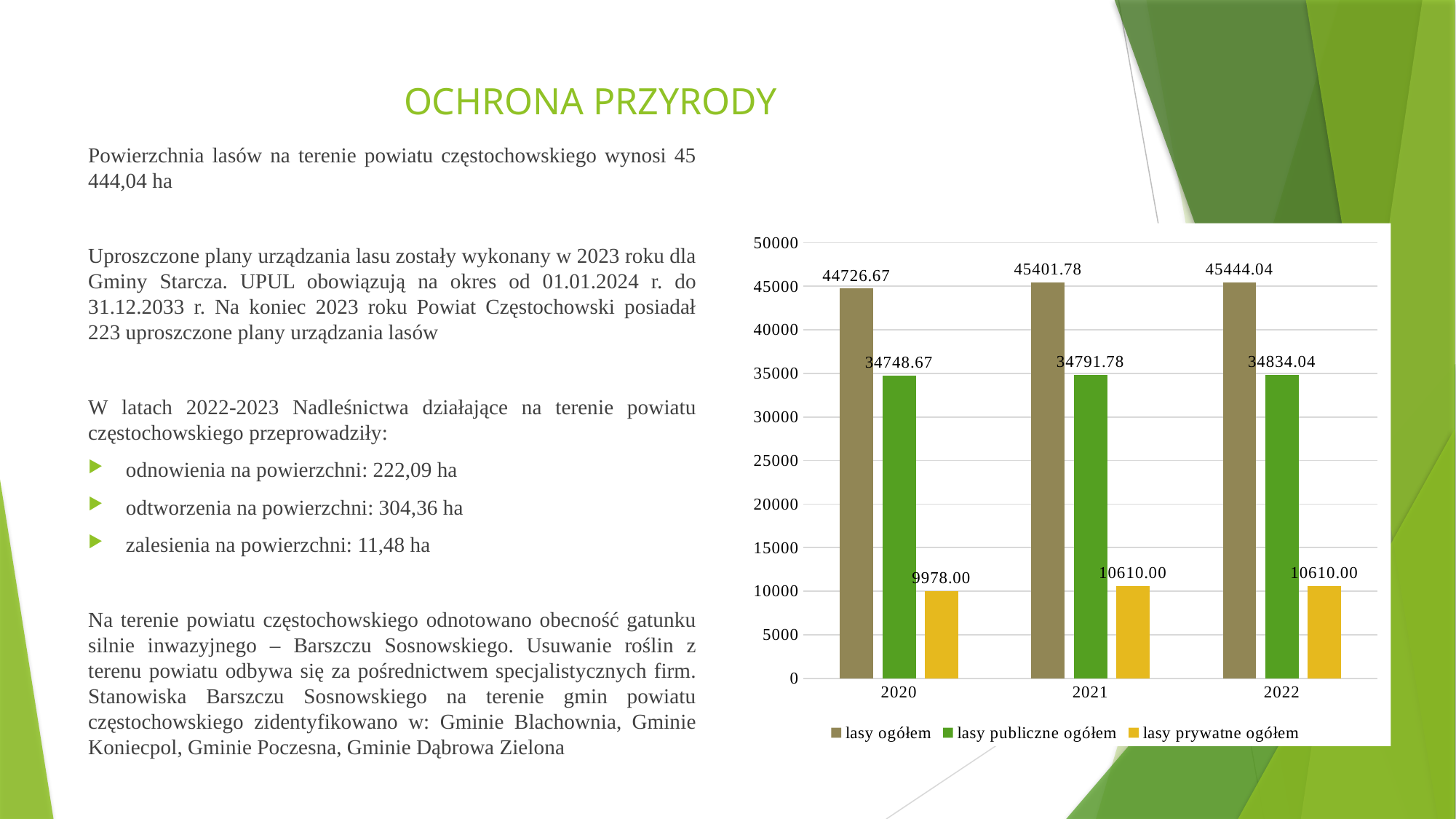
What is the value for "lasy publiczne ogółem" in 2022? 34834.04 In which year is the value for "lasy ogółem" the highest? 2022 Is the value for "lasy publiczne ogółem" in 2021 greater or less than 30000? greater What is the value for "lasy prywatne ogółem" in 2021? 10610.00 How many series does the chart legend list? 3 In which year is the value for "lasy prywatne ogółem" the lowest? 2020 What is the difference between the "lasy prywatne ogółem" values for 2021 and 2020? 632.00 What kind of chart is shown on the slide? bar chart How many years are shown on the x axis of the chart? 3 What is the difference between the "lasy ogółem" values for 2022 and 2020? 717.37 What is the value for "lasy ogółem" in 2020? 44726.67 Which is larger: "lasy publiczne ogółem" in 2020 or "lasy prywatne ogółem" in 2020? lasy publiczne ogółem in 2020